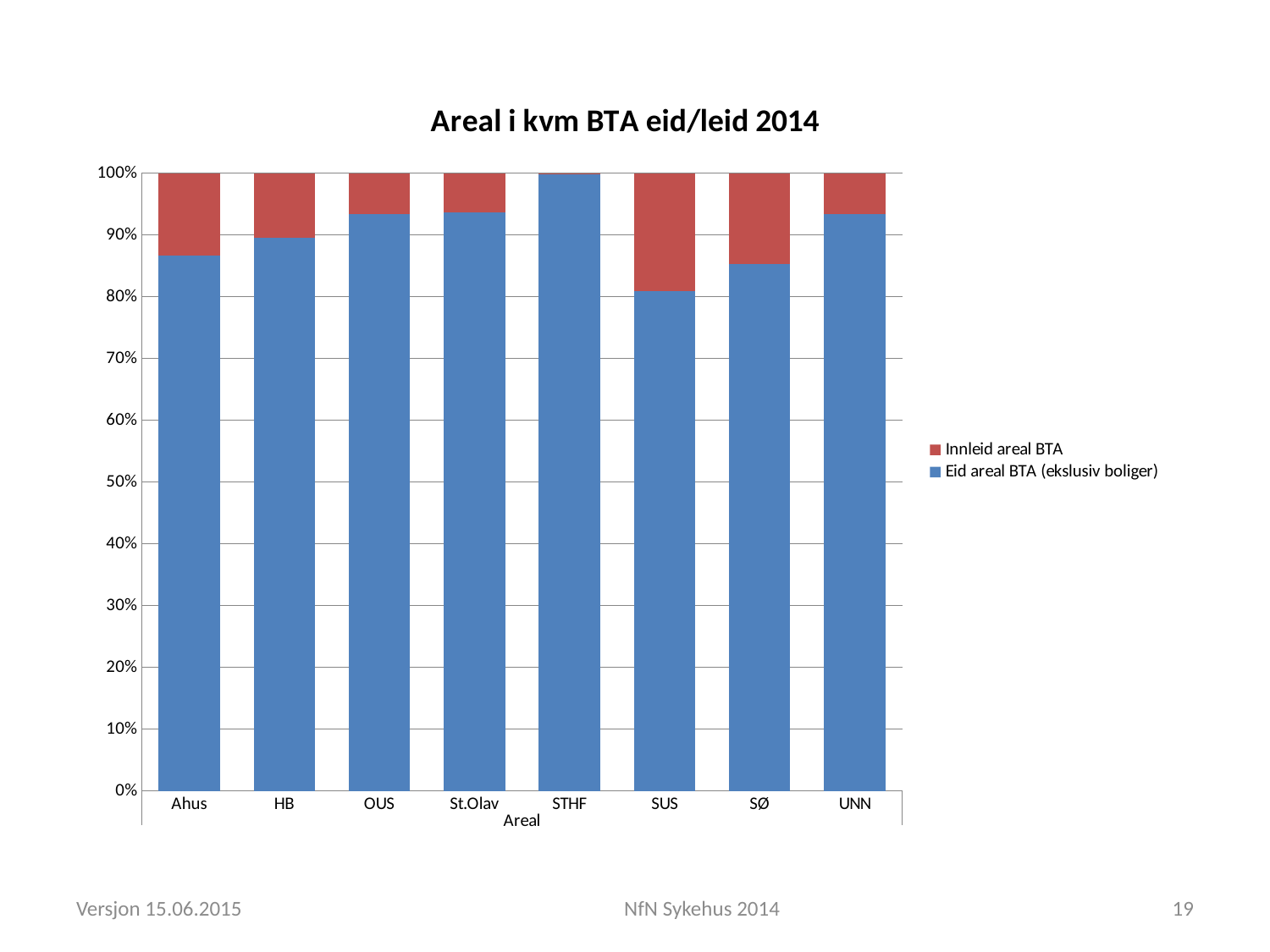
Is the Eid areal BTA (ekslusiv boliger) share for OUS greater or less than 90%? greater How many series does the legend list? 2 Which has a larger share of Eid areal BTA (ekslusiv boliger), Ahus or SUS? Ahus What kind of chart is shown on the slide? Stacked bar chart Is the Eid areal BTA (ekslusiv boliger) share for SØ greater or less than 90%? less What is the title of the chart? Areal i kvm BTA eid/leid 2014 Which series is shown in red? Innleid areal BTA How many categories are shown on the x axis? 8 Is the Eid areal BTA (ekslusiv boliger) share for SUS greater or less than 90%? less Which category has the lowest share of Eid areal BTA (ekslusiv boliger)? SUS Which category has the highest share of Eid areal BTA (ekslusiv boliger)? STHF Which category has the largest share of Innleid areal BTA? SUS